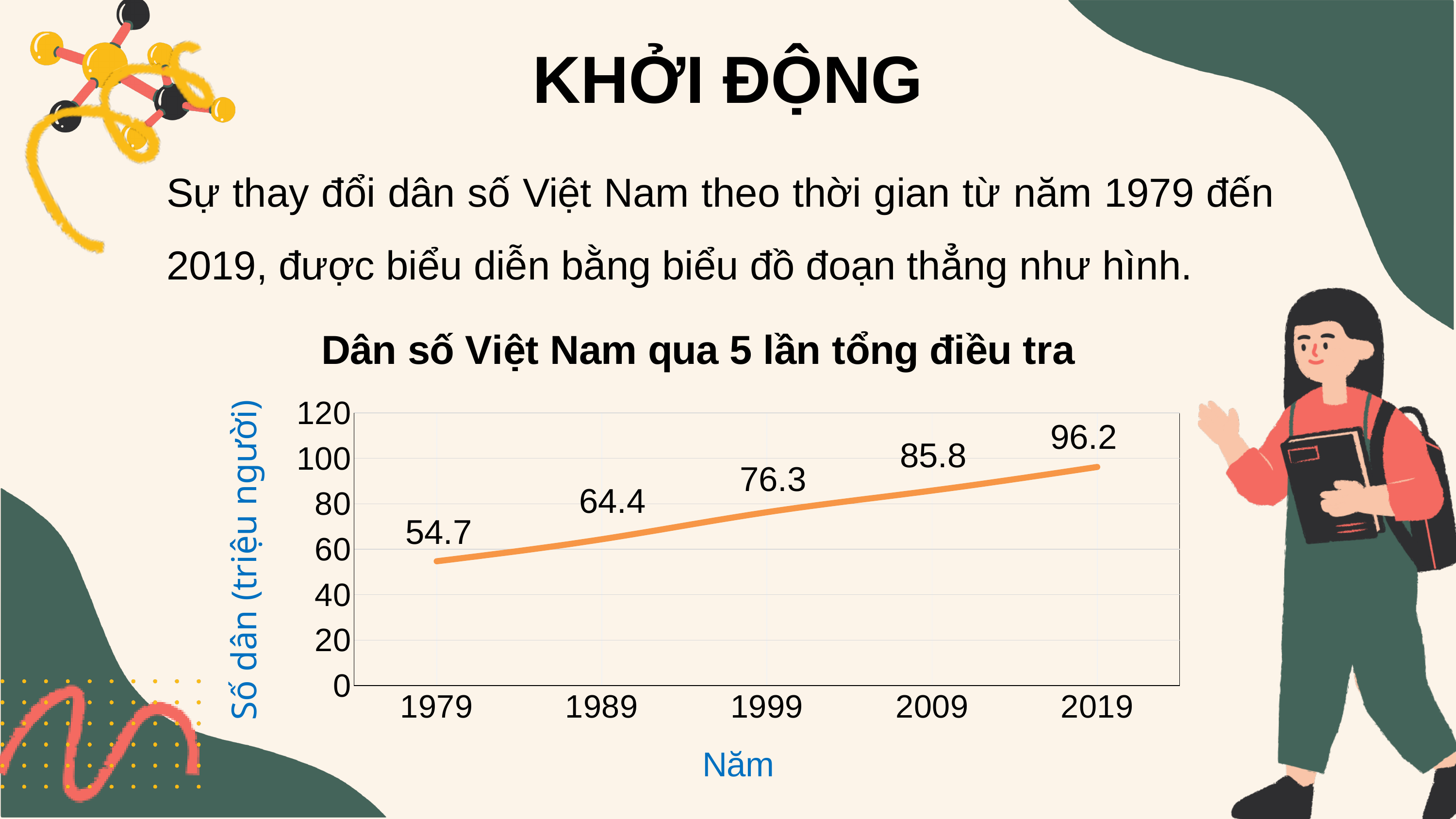
What kind of chart is shown on the slide? line chart Is the value for 2019 greater or less than 100? less What value is shown for the year 1999? 76.3 How many years (data points) are plotted on the chart? 5 What value is shown for the year 2019? 96.2 Do the values rise or fall from 1979 to 2019? rise Which year has the highest population value on the chart? 2019 What is the difference between the values for 2019 and 1979? 41.5 What was Vietnam's population in 1979 according to the chart? 54.7 Which is larger, the value for 1989 or the value for 2009? 2009 Which year has the lowest population value on the chart? 1979 What is the difference between the values for 2009 and 1989? 21.4